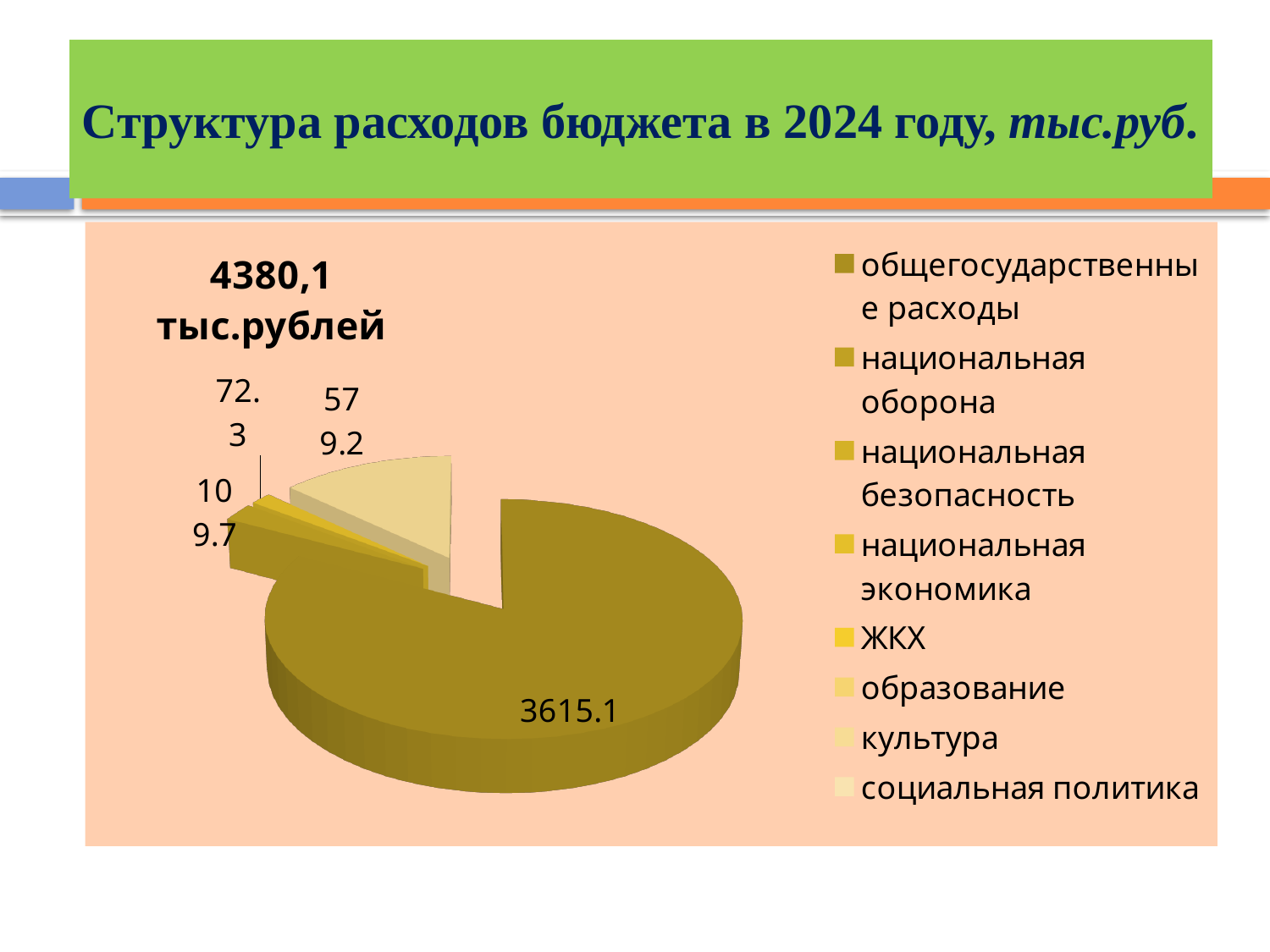
What total amount is printed above the pie chart? 4380,1 тыс.рублей How many entries does the legend of the pie chart list? 8 Is the value for общегосударственные расходы greater or less than 3000? greater What value is printed on the largest slice of the pie? 3615.1 What kind of chart is shown on the slide? pie chart How many data labels are printed on the pie chart? 4 What is the value for общегосударственные расходы? 3615.1 Does the общегосударственные расходы slice make up more or less than half of the pie? more Which category has the largest slice of the pie? общегосударственные расходы What is the title of the chart on the slide? 4380,1 тыс.рублей